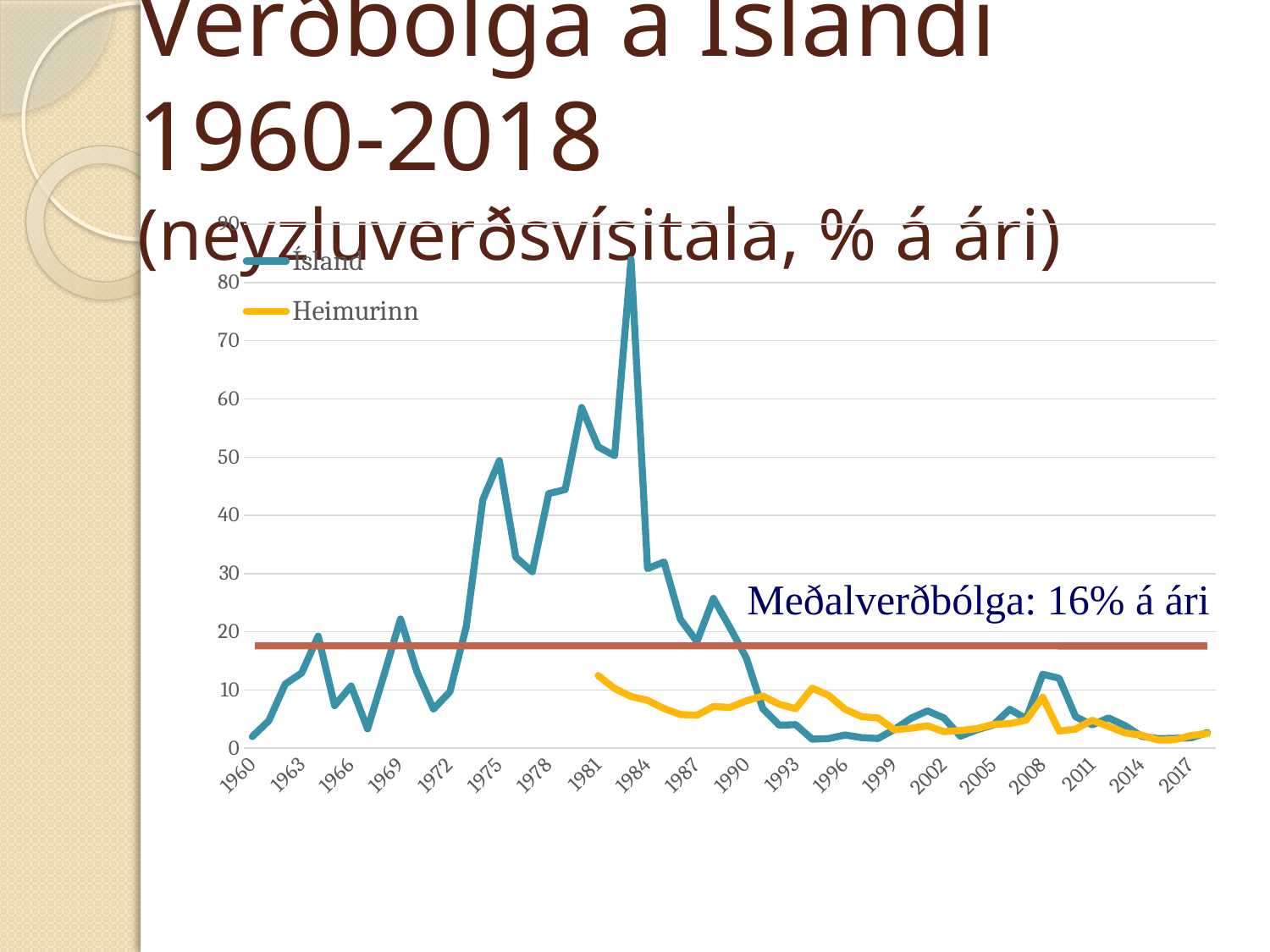
Is the value for Ísland in 1990 greater or less than 20? less What average inflation rate is stated in the annotation on the chart? 16% á ári How many series does the legend list? 2 Is the value for Ísland in 1960 greater or less than 10? less What kind of chart is shown on the slide? line chart Does the Ísland series rise or fall between 1983 and 1990? fall In 1996, which series has the higher value, Ísland or Heimurinn? Heimurinn Is the value for Heimurinn in 1987 greater or less than 10? less In 1984, which series has the higher value, Ísland or Heimurinn? Ísland What are the two series named in the legend? Ísland and Heimurinn